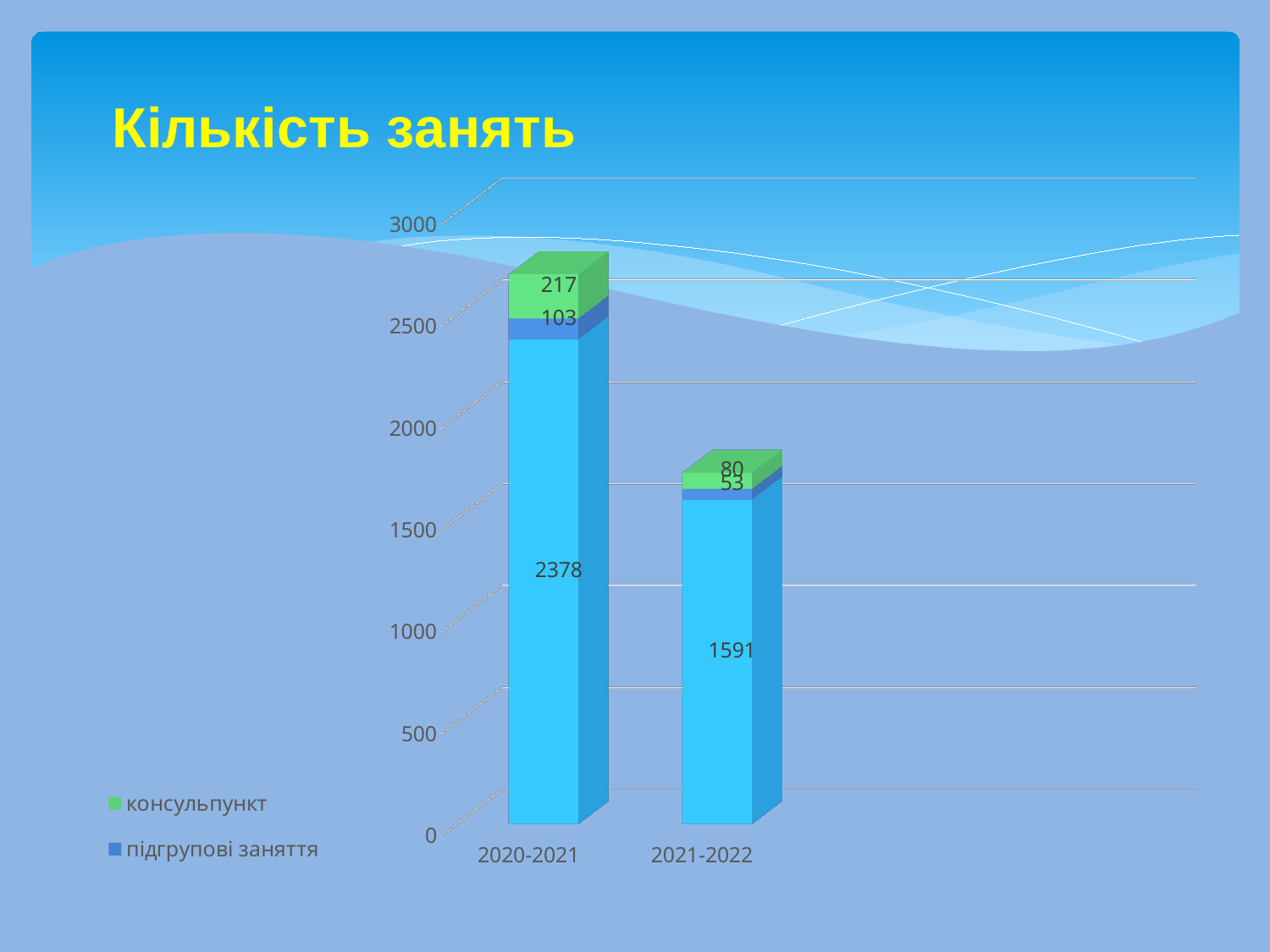
What is the title of the chart? Кількість занять In which year is the консульпункт value larger, 2020-2021 or 2021-2022? 2020-2021 By how much did the консульпункт value decrease from 2020-2021 to 2021-2022? 137 What is the value for консульпункт in 2020-2021? 217 How many categories are shown on the x axis? 2 What is the value for консульпункт in 2021-2022? 80 What is the total of the stacked bar for 2020-2021? 2698 What is the value for підгрупові заняття in 2020-2021? 103 What is the difference between the підгрупові заняття values for 2020-2021 and 2021-2022? 50 What is the value for підгрупові заняття in 2021-2022? 53 What kind of chart is shown on the slide? Stacked bar chart What is the total of the stacked bar for 2021-2022? 1724